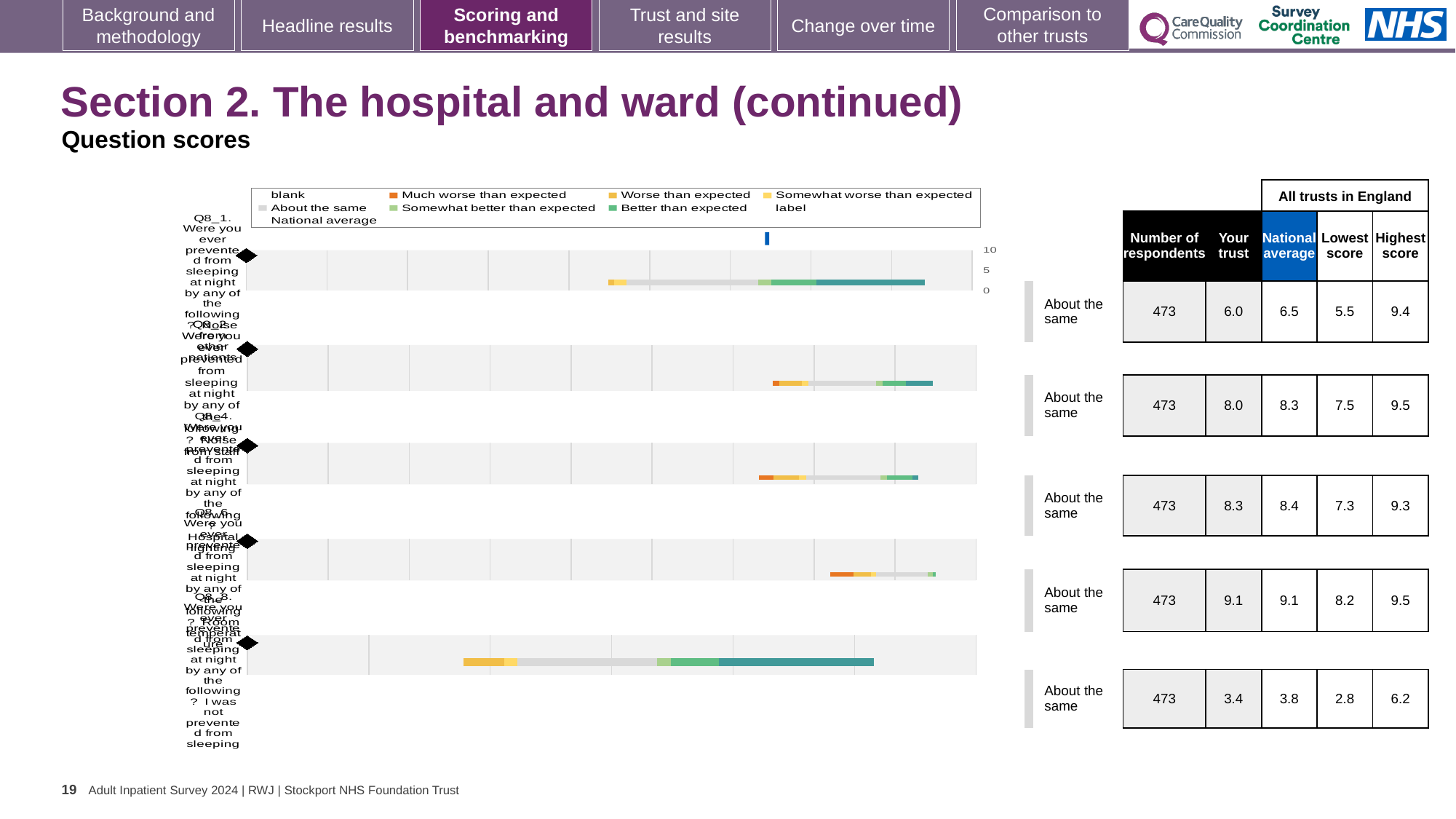
What kind of chart is shown on the slide? bar chart How many question rows (bars) are plotted in the chart? 5 What benchmark category is shown next to each of the five question rows? About the same What is the national average for the first (top) question row? 6.5 What is the maximum value shown on the chart's score axis? 10 For the third question row, which is larger: the 'Your trust' score or the national average? national average What is the 'Your trust' score for the first (top) question row? 6.0 What is the difference between the national average and the 'Your trust' score for the first (top) question row? 0.5 What is the lowest score among all trusts in England for the second question row? 7.5 Which question row has the highest 'Your trust' score? the fourth row (9.1) What is the highest score among all trusts in England for the last (bottom) question row? 6.2 What is the number of respondents shown for the first (top) question row? 473